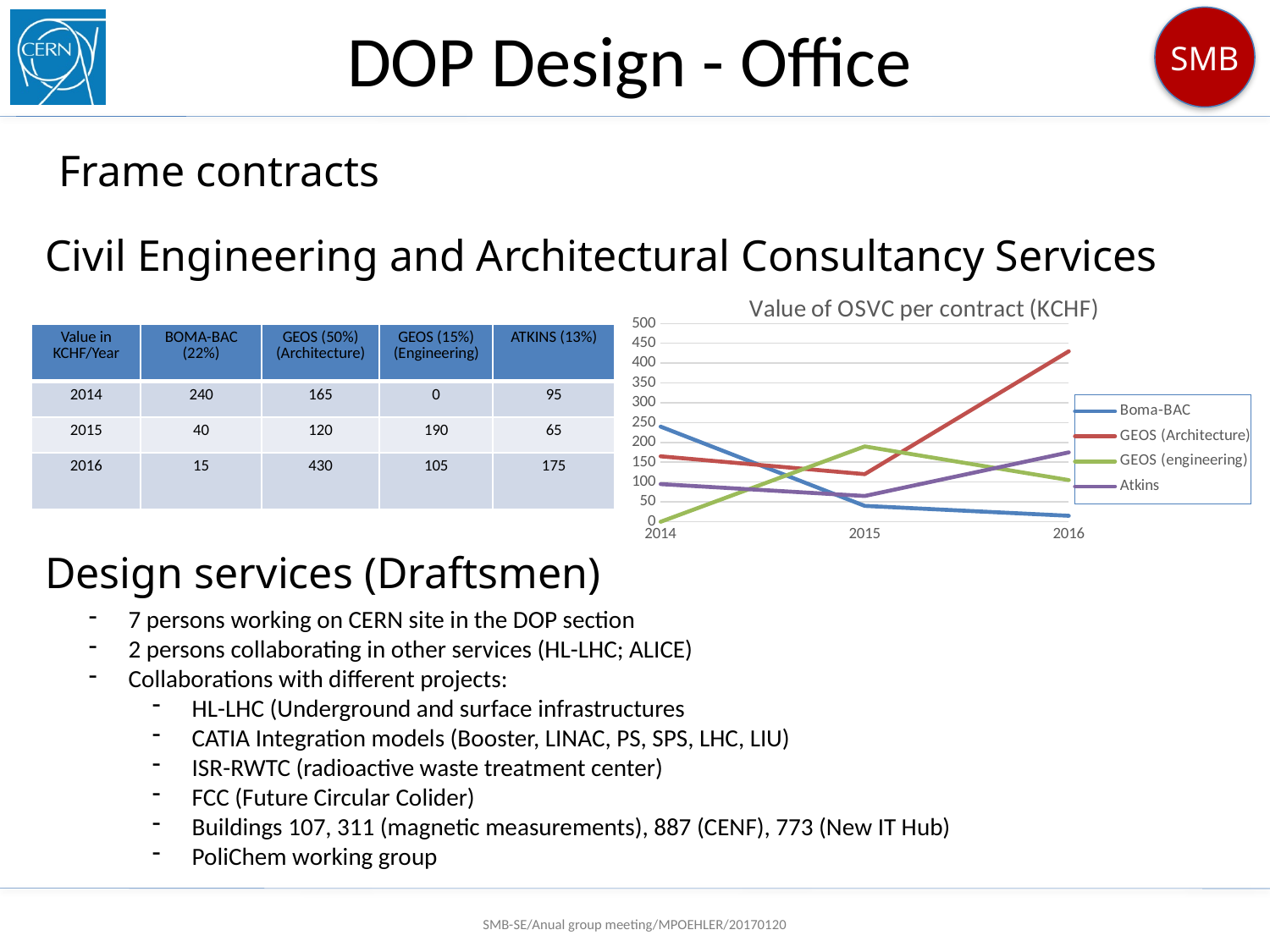
Does the Boma-BAC line rise or fall from 2014 to 2016? fall Which is larger in 2015: GEOS (engineering) or Atkins? GEOS (engineering) How many years are shown on the x axis of the chart? 3 How many series does the chart legend list? 4 What is the value for GEOS (Architecture) in 2016? 430 What is the title of the chart? Value of OSVC per contract (KCHF) Is the value for GEOS (Architecture) in 2016 greater or less than 400? greater What type of chart is shown on the slide? line chart Which series has the highest value in 2016? GEOS (Architecture) What is the difference between the Atkins values in 2016 and 2015? 110 What is the value for Boma-BAC in 2014? 240 Which series has the lowest value in 2014? GEOS (engineering)